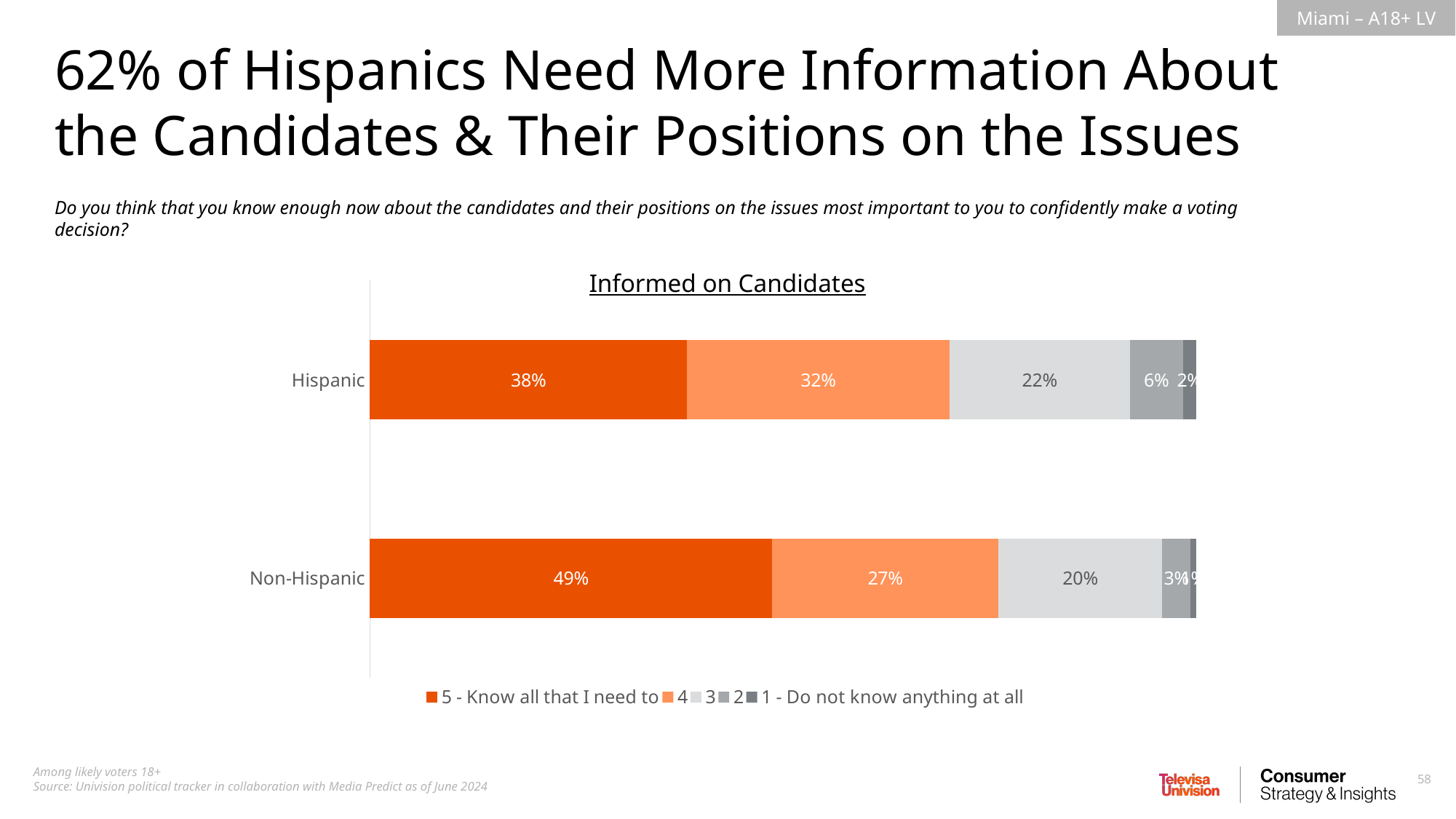
Which group has the larger share answering "5 - Know all that I need to", Hispanic or Non-Hispanic? Non-Hispanic What is the title of the chart? Informed on Candidates What is the difference between the Non-Hispanic and Hispanic shares answering "5 - Know all that I need to"? 11 percentage points How many series does the legend list? 5 What percentage of Non-Hispanic respondents gave a rating of 3? 20% What type of chart is shown on the slide? Stacked bar chart What percentage of Hispanic respondents gave a rating of 2? 6% What percentage of Hispanic respondents gave a rating of 4? 32% What is the difference between the Hispanic and Non-Hispanic shares giving a rating of 4? 5 percentage points How many groups (categories) are shown in the chart? 2 What percentage of Non-Hispanic respondents answered "5 - Know all that I need to"? 49% What percentage of Hispanic respondents answered "5 - Know all that I need to"? 38%